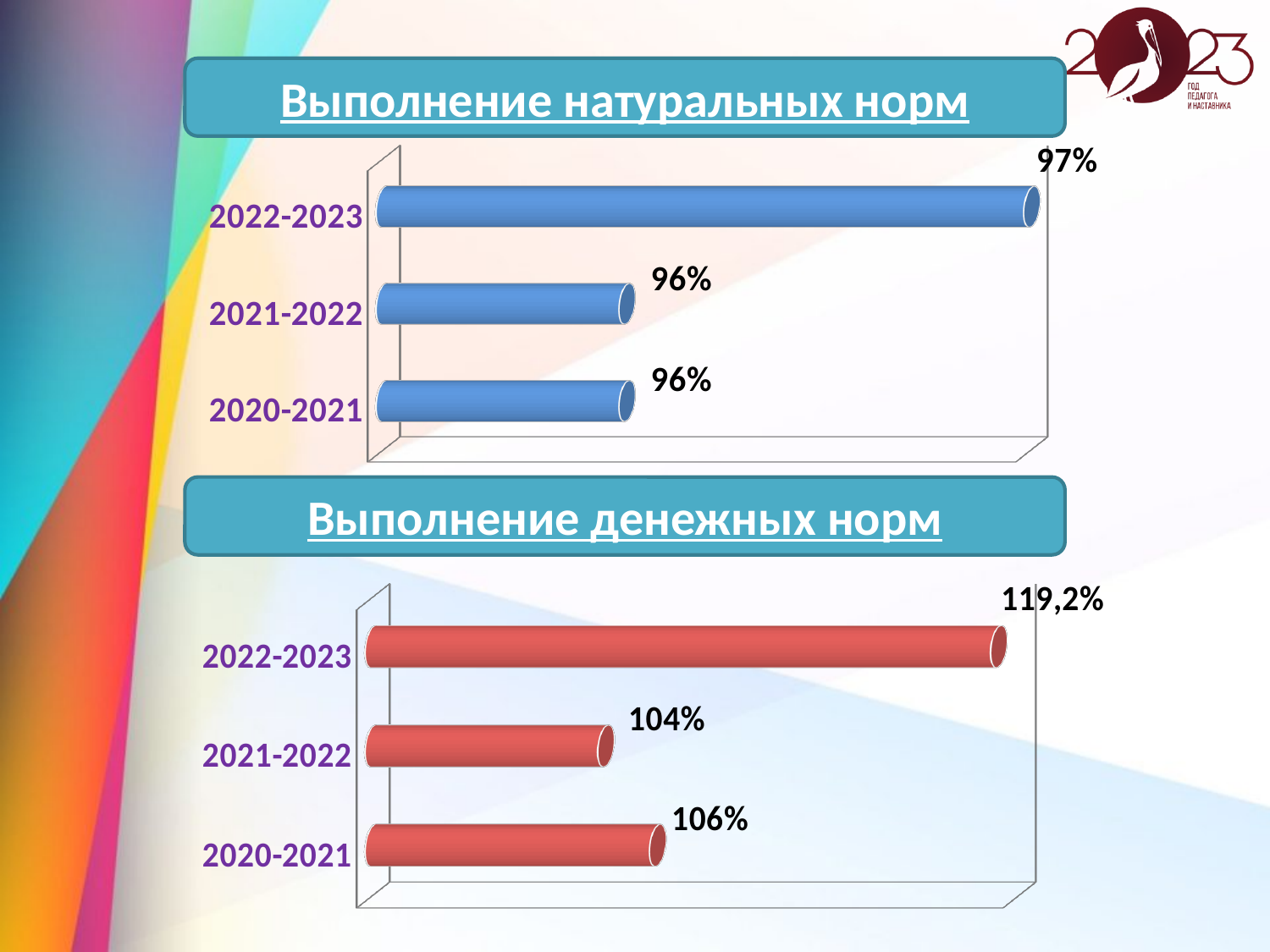
In the chart titled "Выполнение денежных норм", what is the value for 2022-2023? 119,2% In the chart titled "Выполнение натуральных норм", what is the difference between the values for 2022-2023 and 2021-2022? 1% In the chart titled "Выполнение денежных норм", what is the difference between the values for 2020-2021 and 2021-2022? 2% In the chart titled "Выполнение натуральных норм", what is the value for 2022-2023? 97% In the chart titled "Выполнение денежных норм", which period has the lowest value? 2021-2022 How many periods are shown in the chart titled "Выполнение денежных норм"? 3 In the chart titled "Выполнение денежных норм", which is larger, the value for 2020-2021 or the value for 2021-2022? 2020-2021 In the chart titled "Выполнение натуральных норм", which period has the highest value? 2022-2023 In the chart titled "Выполнение денежных норм", what is the value for 2020-2021? 106% In the chart titled "Выполнение натуральных норм", what is the value for 2021-2022? 96% What type of chart is the chart titled "Выполнение натуральных норм"? Bar chart In the chart titled "Выполнение денежных норм", what is the value for 2021-2022? 104%